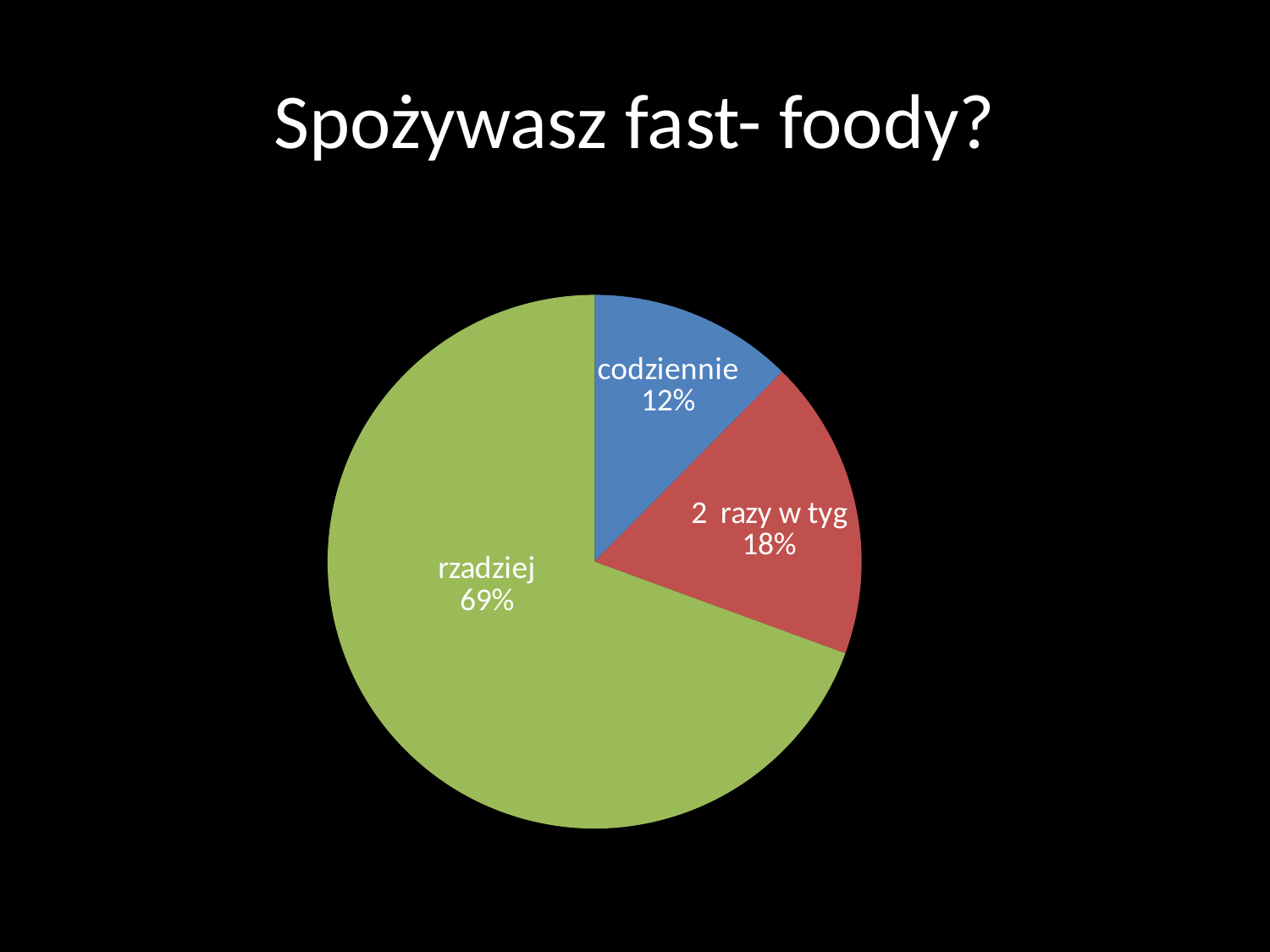
What is the value shown for "codziennie"? 12% Which category has the smallest slice of the pie? codziennie What is the value shown for "2 razy w tyg"? 18% What is the title of the slide? Spożywasz fast- foody? Which category has the largest slice of the pie? rzadziej What is the difference between the "2 razy w tyg" and "codziennie" values? 6% What share of the pie does the "rzadziej" slice represent? 69% What colour is the "rzadziej" slice? green Which is larger, the value for "codziennie" or the value for "2 razy w tyg"? 2 razy w tyg How many categories are shown in the pie chart? 3 What kind of chart is shown on the slide? pie chart What is the difference between the "rzadziej" and "2 razy w tyg" values? 51%